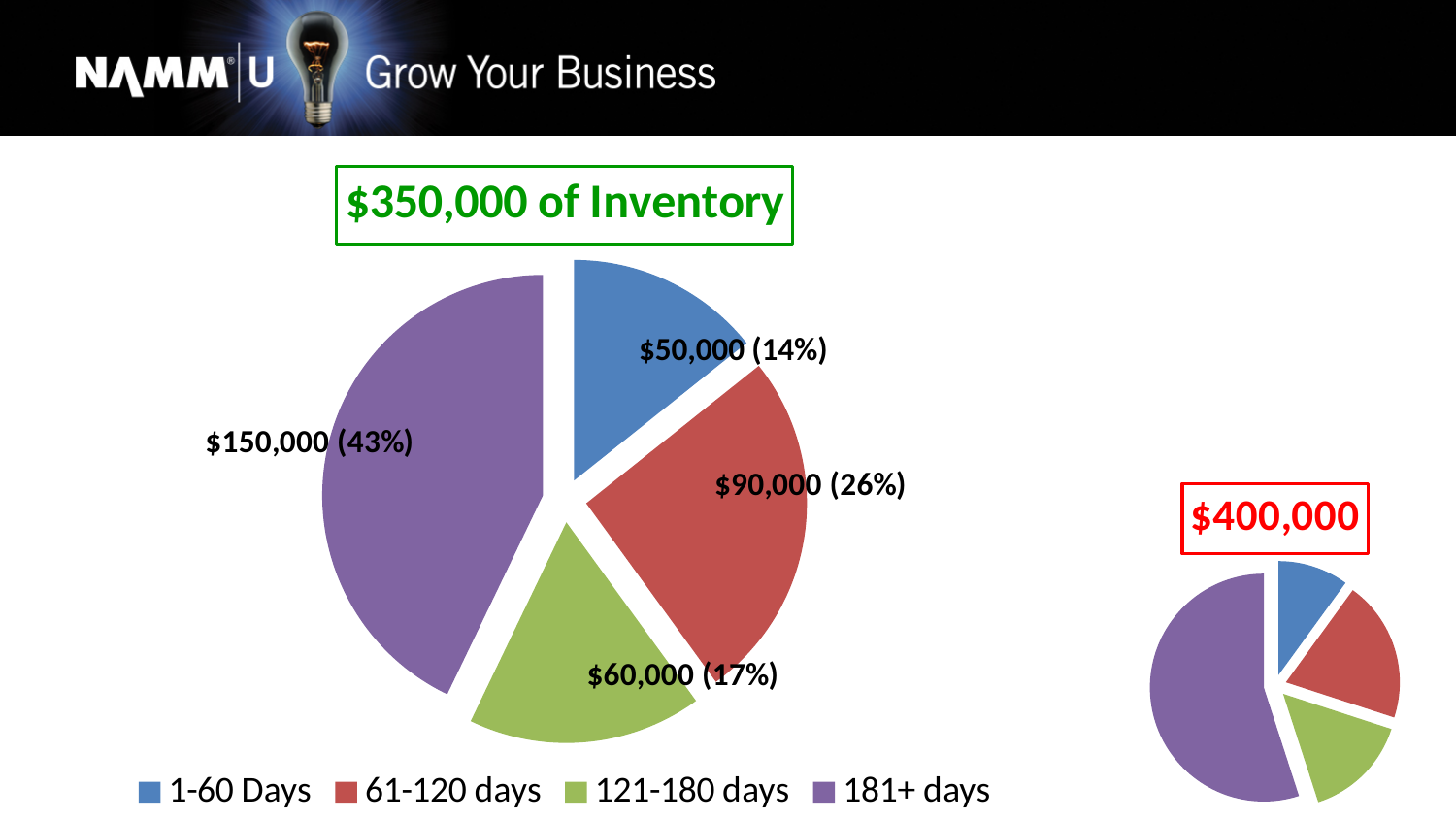
In the "$350,000 of Inventory" pie chart, which category has the largest slice? 181+ days In the "$350,000 of Inventory" pie chart, what is the difference in dollars between the 181+ days slice and the 61-120 days slice? $60,000 How many categories does the legend below the "$350,000 of Inventory" pie chart list? 4 What colour represents the 181+ days category in the legend? Purple In the "$350,000 of Inventory" pie chart, which is larger: the 61-120 days slice or the 121-180 days slice? 61-120 days In the "$350,000 of Inventory" pie chart, what value is shown for the 121-180 days slice? $60,000 (17%) In the "$350,000 of Inventory" pie chart, what share of the pie does the 181+ days slice represent? 43% In the small "$400,000" pie chart on the right, which colour slice is the largest? Purple What kind of chart is the large chart titled "$350,000 of Inventory"? Pie chart In the "$350,000 of Inventory" pie chart, what value is shown for the 1-60 Days slice? $50,000 (14%) In the "$350,000 of Inventory" pie chart, which category has the smallest slice? 1-60 Days In the "$350,000 of Inventory" pie chart, what value is shown for the 61-120 days slice? $90,000 (26%)